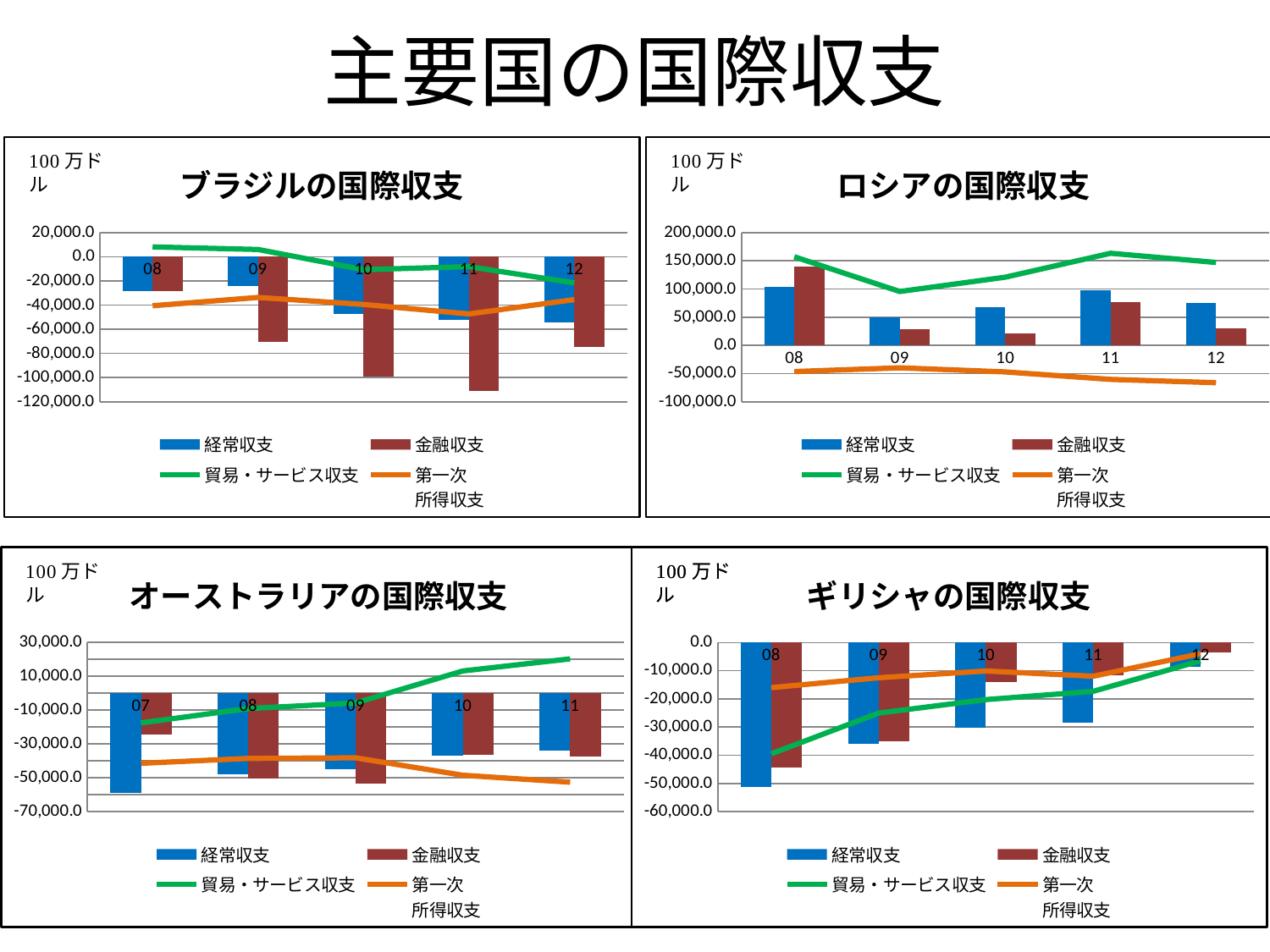
In the オーストラリアの国際収支 chart, in which year is 経常収支 lowest? 07 In the ブラジルの国際収支 chart, is the 経常収支 value for 08 greater or less than -20,000.0? less In the ギリシャの国際収支 chart, which year has the larger 金融収支 value, 08 or 12? 12 What kind of chart is the ギリシャの国際収支 chart? combined bar and line chart In the ロシアの国際収支 chart, does the 第一次所得収支 line rise or fall from 09 to 12? fall In the ブラジルの国際収支 chart, how many series does the legend list? 4 In the ロシアの国際収支 chart, in which year is 金融収支 highest? 08 How many charts are shown on the slide? 4 In the ブラジルの国際収支 chart, how many years are shown on the x axis? 5 In the ロシアの国際収支 chart, is the 金融収支 value for 08 greater or less than 100,000.0? greater In the ブラジルの国際収支 chart, in which year is 金融収支 lowest? 11 In the オーストラリアの国際収支 chart, does the 貿易・サービス収支 line rise or fall from 07 to 11? rise